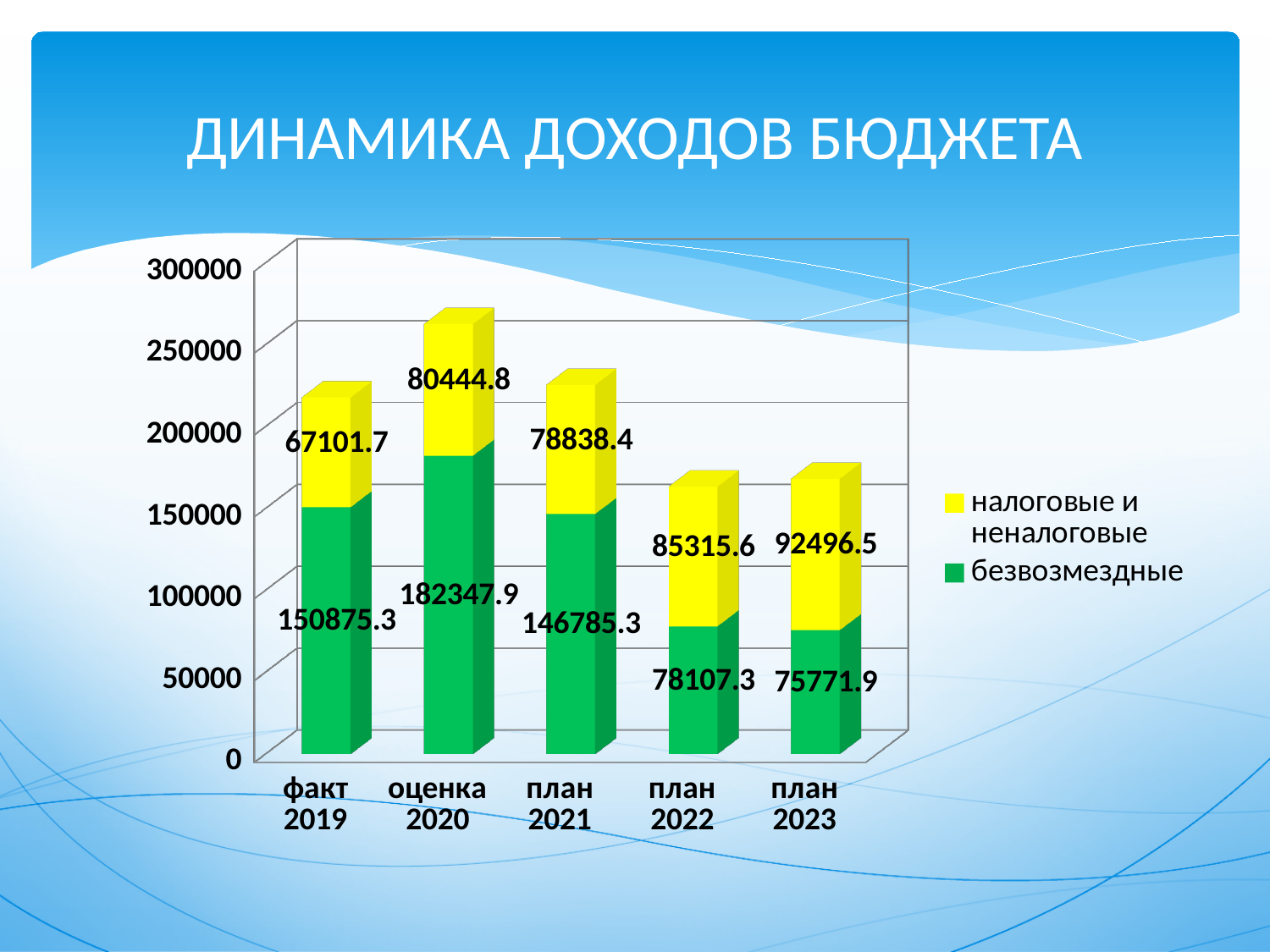
Which category has the lowest value for налоговые и неналоговые? факт 2019 How many categories are shown on the x axis? 5 What is the value of безвозмездные for план 2022? 78107.3 How many series does the legend list? 2 What is the total of the stacked bar for факт 2019? 217977.0 Which is larger: безвозмездные for план 2021 or безвозмездные for план 2023? план 2021 Which category has the highest value for безвозмездные? оценка 2020 What type of chart is shown on the slide? stacked bar chart What is the value of налоговые и неналоговые for план 2023? 92496.5 What is the value of безвозмездные for оценка 2020? 182347.9 What is the title of the chart? ДИНАМИКА ДОХОДОВ БЮДЖЕТА What is the difference between налоговые и неналоговые for план 2023 and план 2022? 7180.9